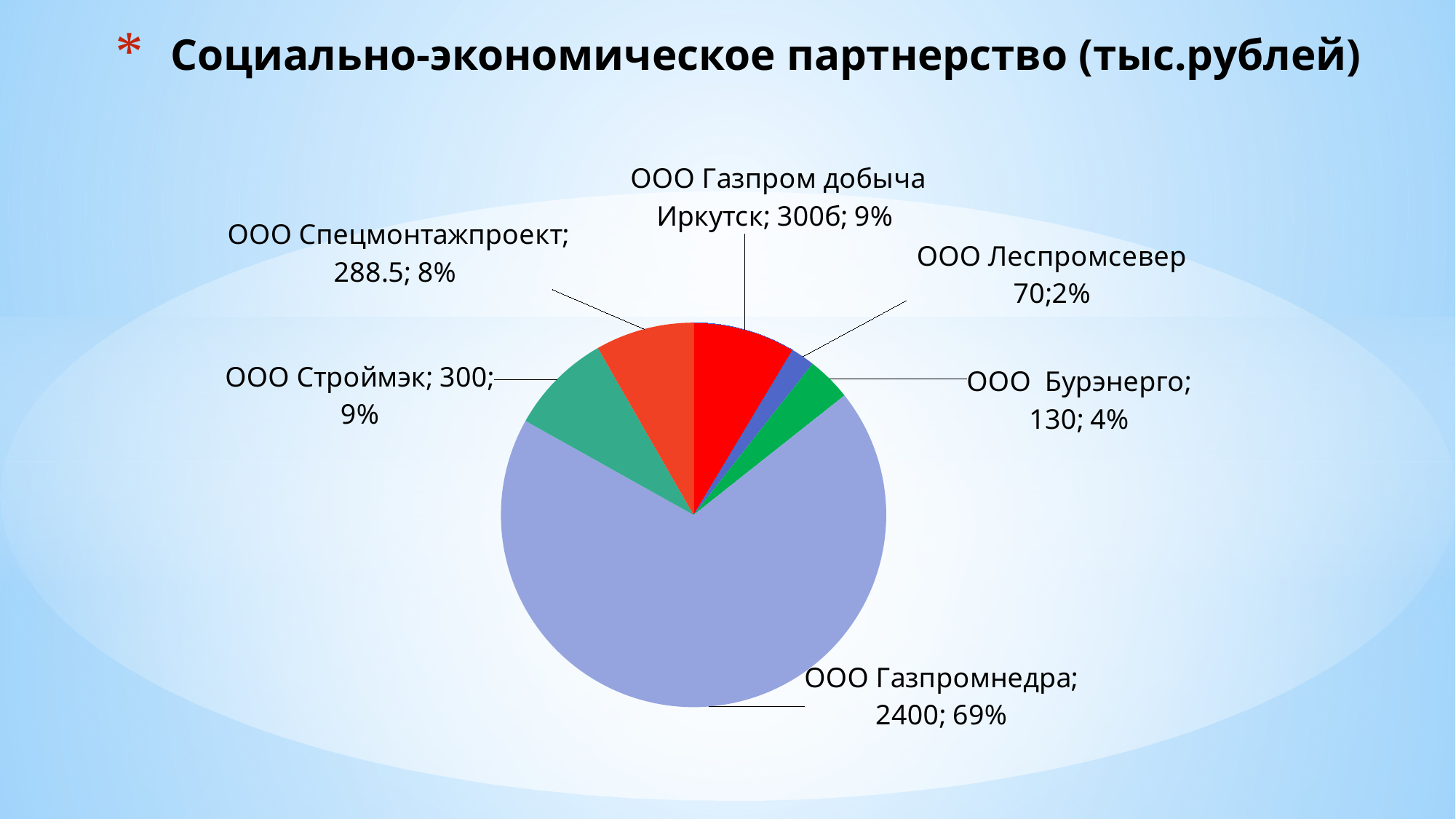
Which company has the smallest slice of the pie chart? ООО Леспромсевер What is the difference between the values for ООО Газпромнедра and ООО Строймэк? 2100 Which is larger, the value for ООО Бурэнерго or the value for ООО Леспромсевер? ООО Бурэнерго What kind of chart is shown on the slide? pie chart What is the value shown for ООО Газпромнедра? 2400 What share of the pie does ООО Леспромсевер account for? 2% What share of the pie does ООО Газпромнедра account for? 69% How many slices does the pie chart have? 6 What is the value shown for ООО Бурэнерго? 130 Which company has the largest slice of the pie chart? ООО Газпромнедра What is the title of the chart on the slide? Социально-экономическое партнерство (тыс.рублей) What is the value shown for ООО Спецмонтажпроект? 288.5